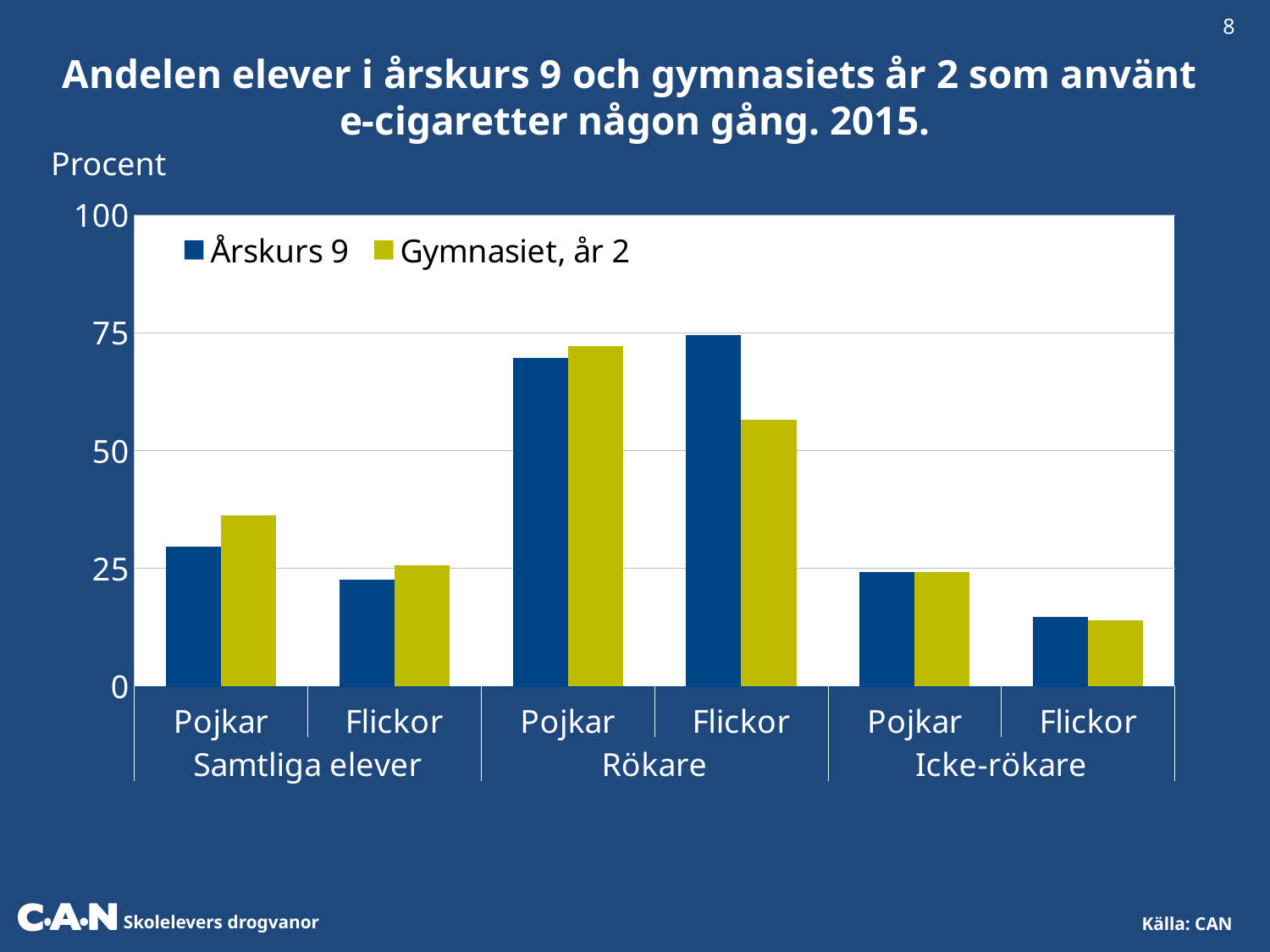
Which category has the highest value for the Årskurs 9 series? Flickor, Rökare How many main category groups are shown along the x axis? 3 How many series does the legend list? 2 Is the Gymnasiet, år 2 value for Pojkar among Samtliga elever greater or less than 25? greater Is the Gymnasiet, år 2 value for Flickor among Rökare greater or less than 50? greater What are the two series named in the legend? Årskurs 9 and Gymnasiet, år 2 For Flickor among Rökare, which series has the larger value, Årskurs 9 or Gymnasiet, år 2? Årskurs 9 Which category has the lowest value for the Gymnasiet, år 2 series? Flickor, Icke-rökare Which category has the highest value for the Gymnasiet, år 2 series? Pojkar, Rökare For Pojkar among Samtliga elever, which series has the larger value, Årskurs 9 or Gymnasiet, år 2? Gymnasiet, år 2 What kind of chart is shown on the slide? bar chart Is the Årskurs 9 value for Flickor among Icke-rökare greater or less than 25? less